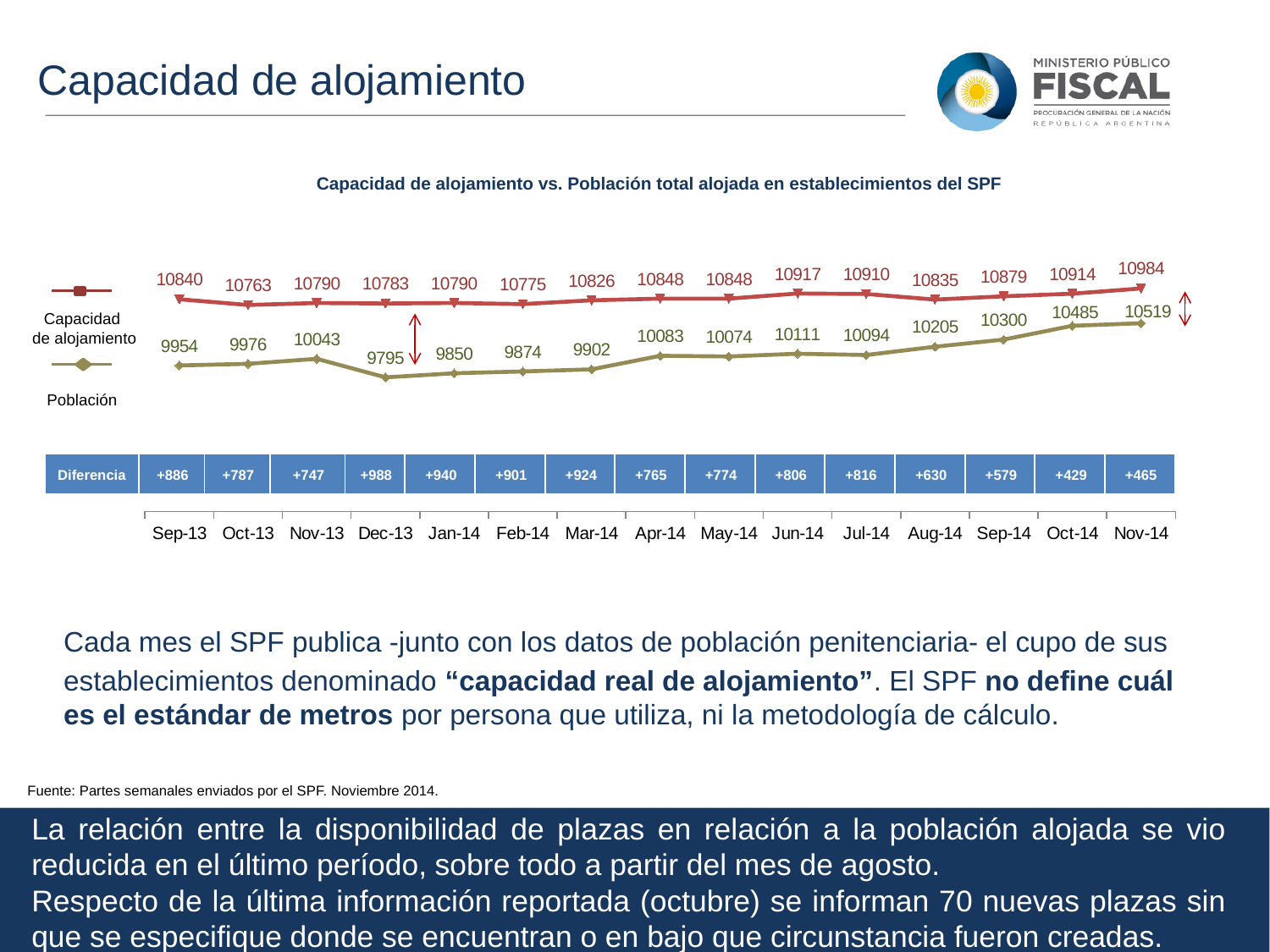
What is the difference between Capacidad de alojamiento and Población in Nov-14? 465 Does Población rise or fall from Aug-14 to Nov-14? Rise What is the value of Población for Nov-14? 10519 How many series does the legend list? 2 Which is larger, Población in Oct-14 or Población in Aug-14? Oct-14 In which month is Población lowest? Dec-13 In which month is Capacidad de alojamiento highest? Nov-14 How many months are plotted on the x axis? 15 What is the difference between Población in Nov-14 and Población in Sep-13? 565 What kind of chart is shown? Line chart What is the value of Población for Dec-13? 9795 What is the value of Capacidad de alojamiento for Sep-13? 10840